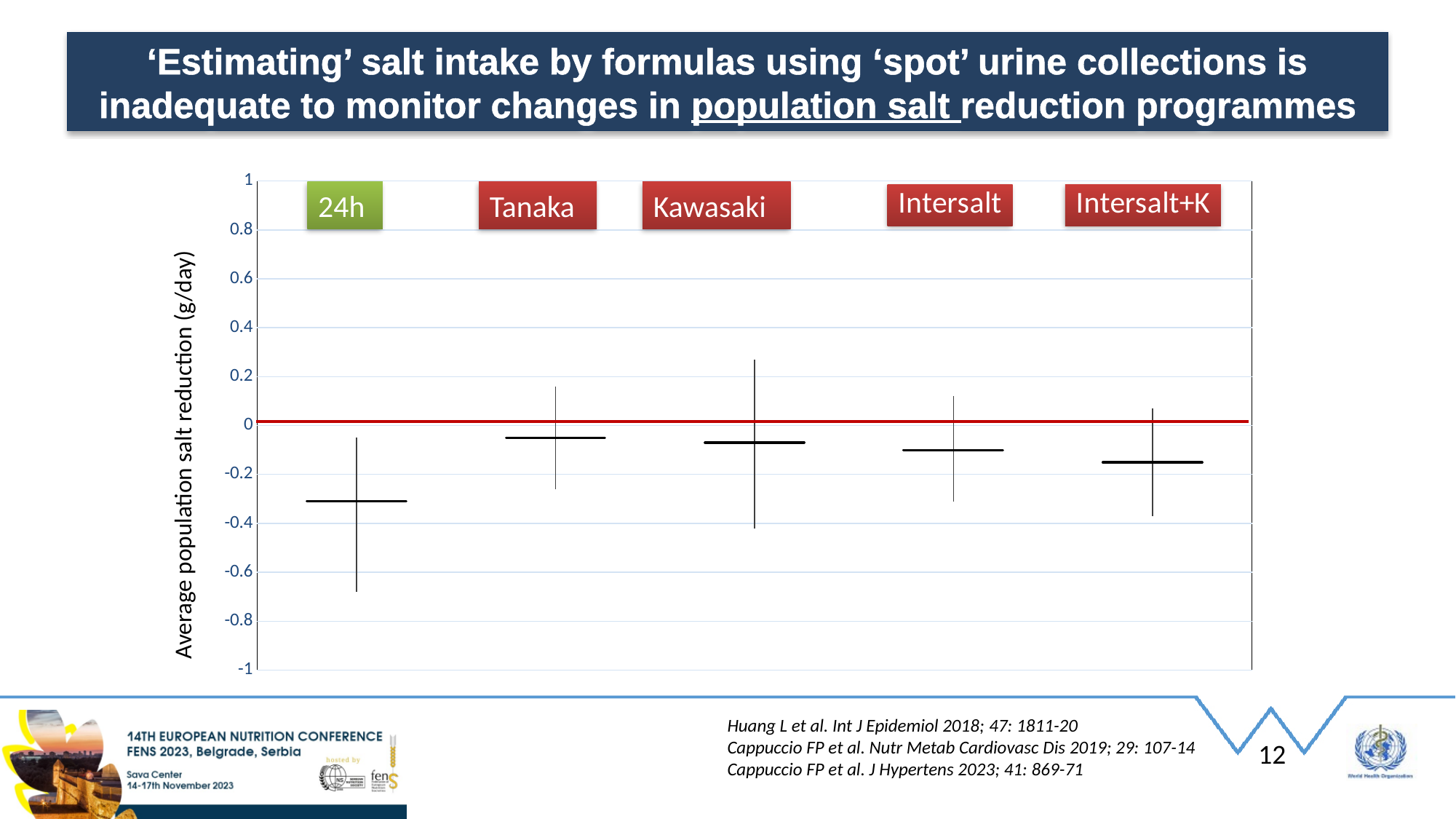
Which method shows the lowest (most negative) average population salt reduction? 24h Is the value for Tanaka greater or less than -0.2? greater At what y-axis value is the horizontal red line drawn? 0 How many methods (categories) are plotted on the chart? 5 Is the value for Kawasaki greater or less than -0.4? greater What is the label of the y axis? Average population salt reduction (g/day) What are the minimum and maximum values shown on the y axis? -1 and 1 Which has the larger value, 24h or Tanaka? Tanaka Is the value for Intersalt+K greater or less than 0? less Which has the larger value, 24h or Intersalt+K? Intersalt+K Which category label is shown in a green box rather than a red one? 24h